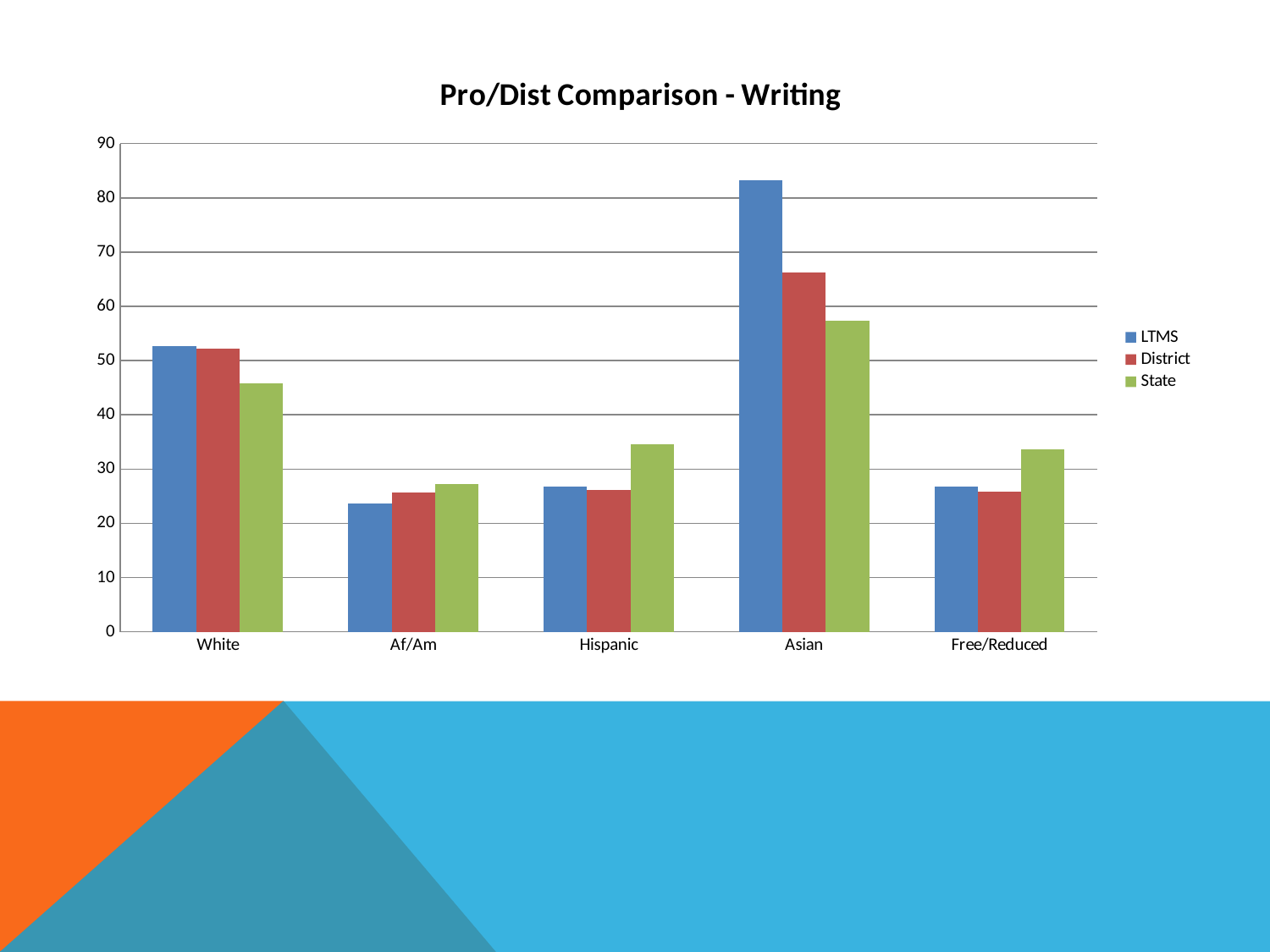
For Free/Reduced, which is larger: the State value or the LTMS value? State Is the LTMS value for Asian greater or less than 80? greater How many categories are shown on the x axis? 5 What kind of chart is shown on the slide? bar chart How many series does the legend list? 3 Which category has the highest LTMS value? Asian Is the State value for White greater or less than 50? less Is the State value for Hispanic greater or less than 30? greater What is the title of the chart? Pro/Dist Comparison - Writing For Asian, which is larger: the LTMS value or the District value? LTMS Which category has the lowest LTMS value? Af/Am